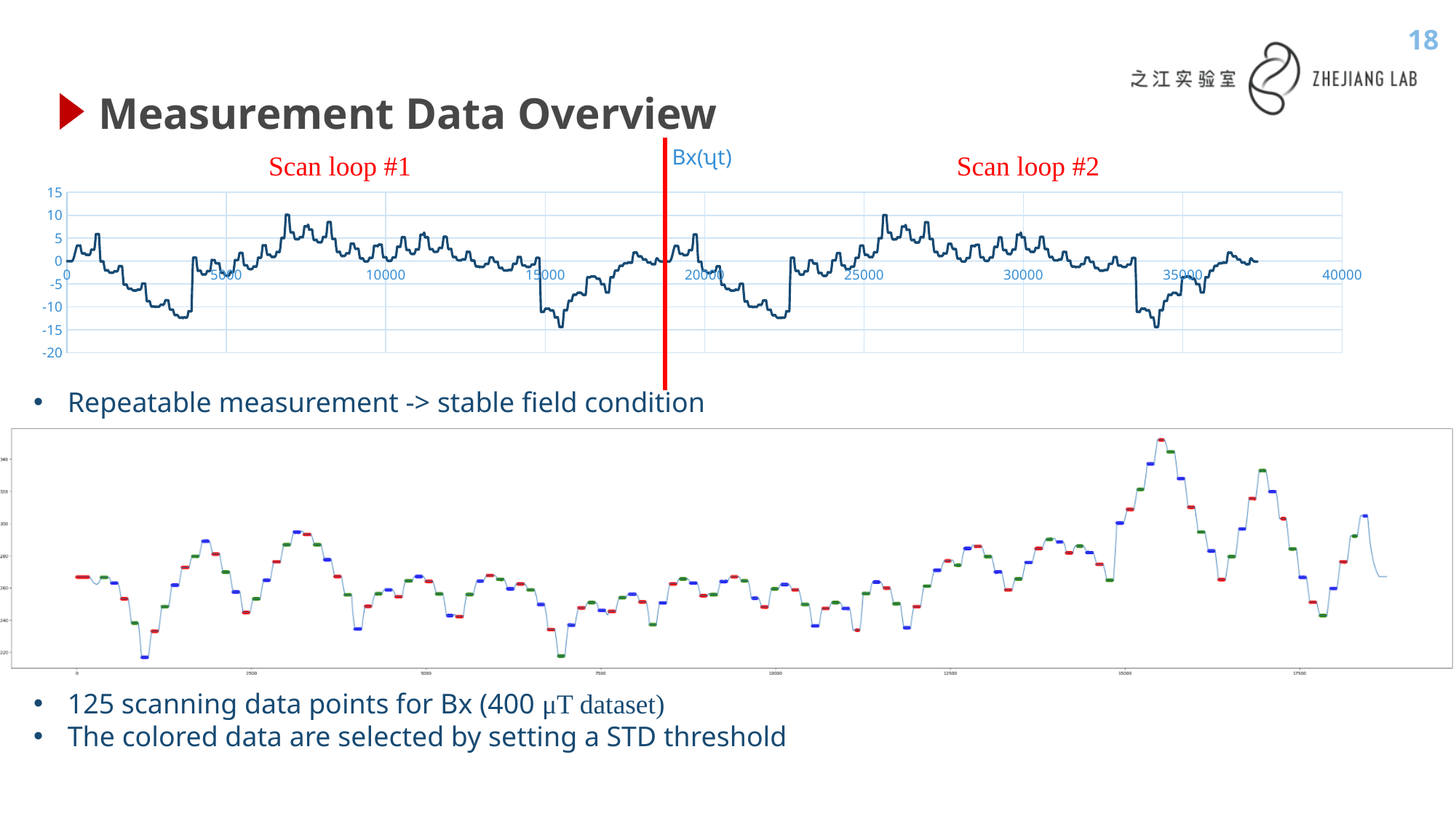
What kind of chart is the bottom chart with the colored segments? line chart In the top chart, what is the largest value labelled on the x axis? 40000 In the top chart, is the lowest point of the line greater or less than -10? less What kind of chart is the top chart labelled Bx? line chart How many scanning data points for Bx are shown in the bottom chart? 125 In the top chart, is the value at x = 25000 greater or less than -5? greater In the top chart, is the value at x = 10000 greater or less than -5? greater How many scan loops are marked on the top chart? 2 How many lines are plotted in the top chart? 1 In the top chart, what is the lowest value shown on the y axis? -20 In the top chart, what is the highest value shown on the y axis? 15